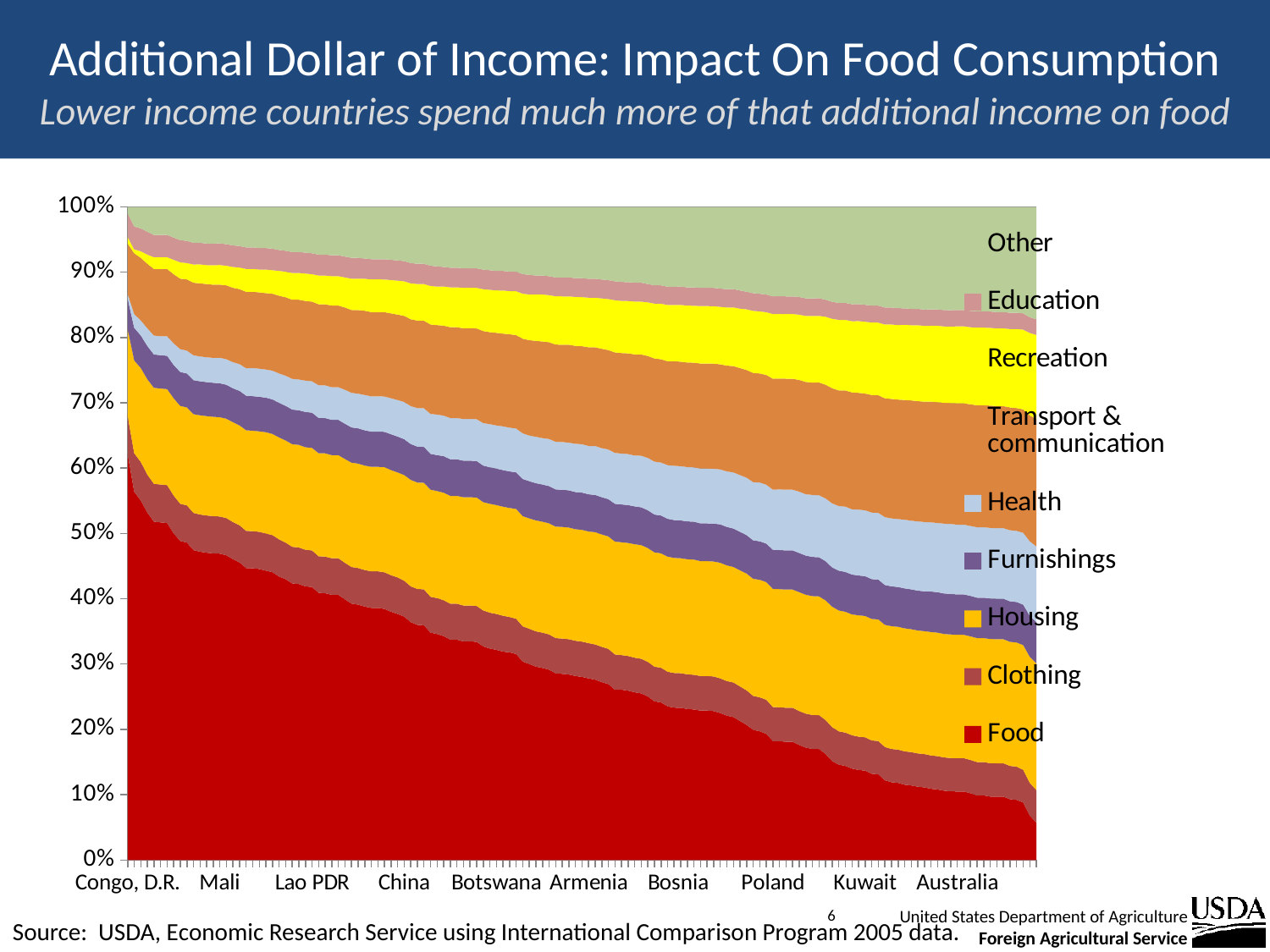
Which has a larger Food share, Mali or Poland? Mali Which labeled country has the highest Food share? Congo, D.R. What kind of chart is shown on the slide? Stacked area chart Is the Food share for China greater or less than 30%? greater Is the Food share for Kuwait greater or less than 20%? less How many country labels are shown along the x axis? 10 Which series is shown in red at the bottom of the stack? Food Which labeled country has the lowest Food share? Australia How many series does the legend list? 9 Is the Food share for Australia greater or less than 20%? less Does the share of additional income spent on Food rise or fall moving from Congo, D.R. to Australia along the x axis? Fall